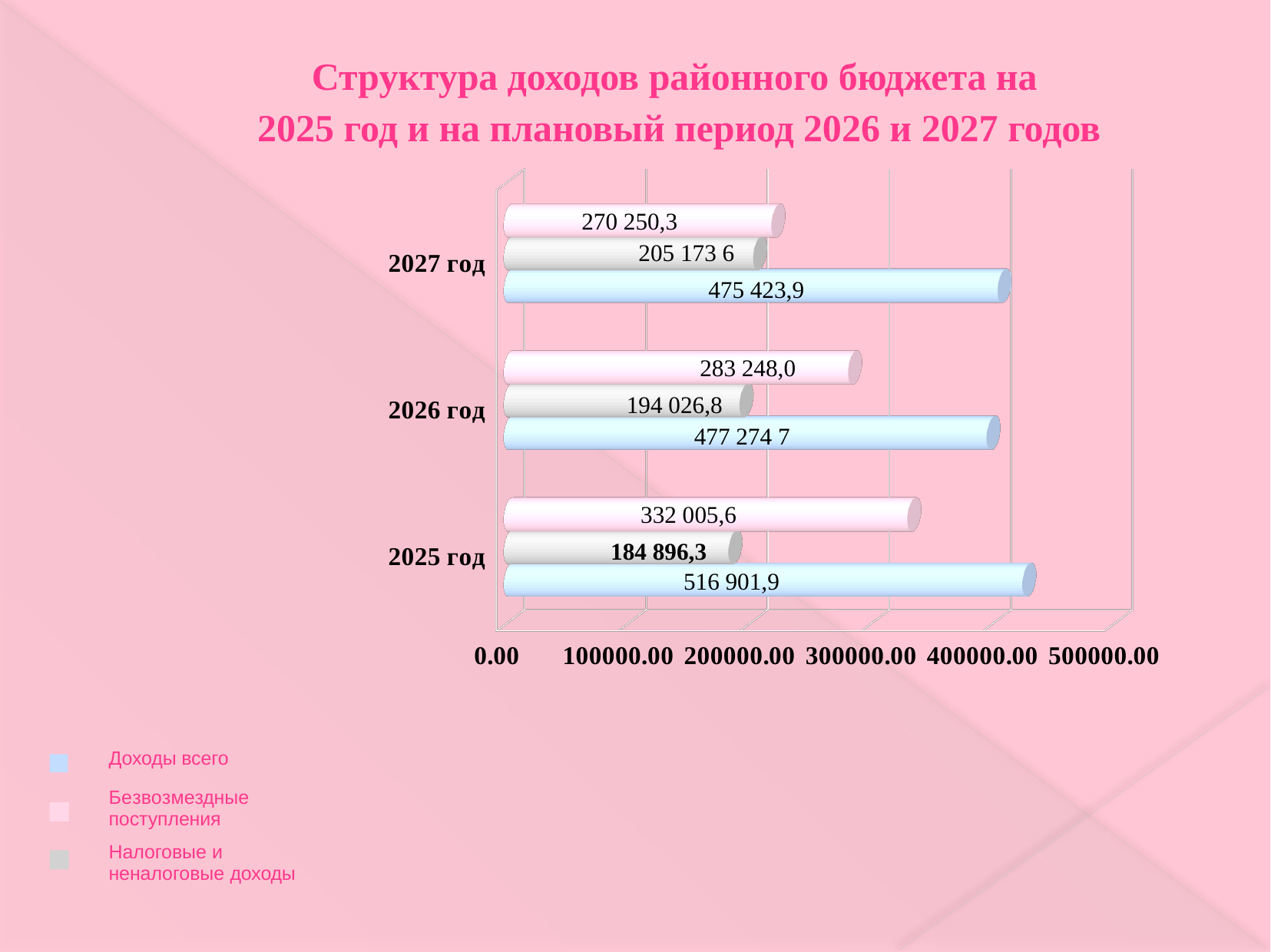
Which year has the lowest value of Безвозмездные поступления? 2027 год For 2025 год, which is larger: Безвозмездные поступления or Налоговые и неналоговые доходы? Безвозмездные поступления What is the difference between Безвозмездные поступления and Налоговые и неналоговые доходы for 2025 год? 147 109,3 Which year has the highest value of Доходы всего? 2025 год How many series does the legend list? 3 What is the value of Налоговые и неналоговые доходы for 2026 год? 194 026,8 What is the value of Доходы всего for 2027 год? 475 423,9 What is the value of Безвозмездные поступления for 2026 год? 283 248,0 What is the value of Безвозмездные поступления for 2027 год? 270 250,3 What is the value of Доходы всего for 2025 год? 516 901,9 What is the value of Налоговые и неналоговые доходы for 2025 год? 184 896,3 What kind of chart is shown on the slide? bar chart